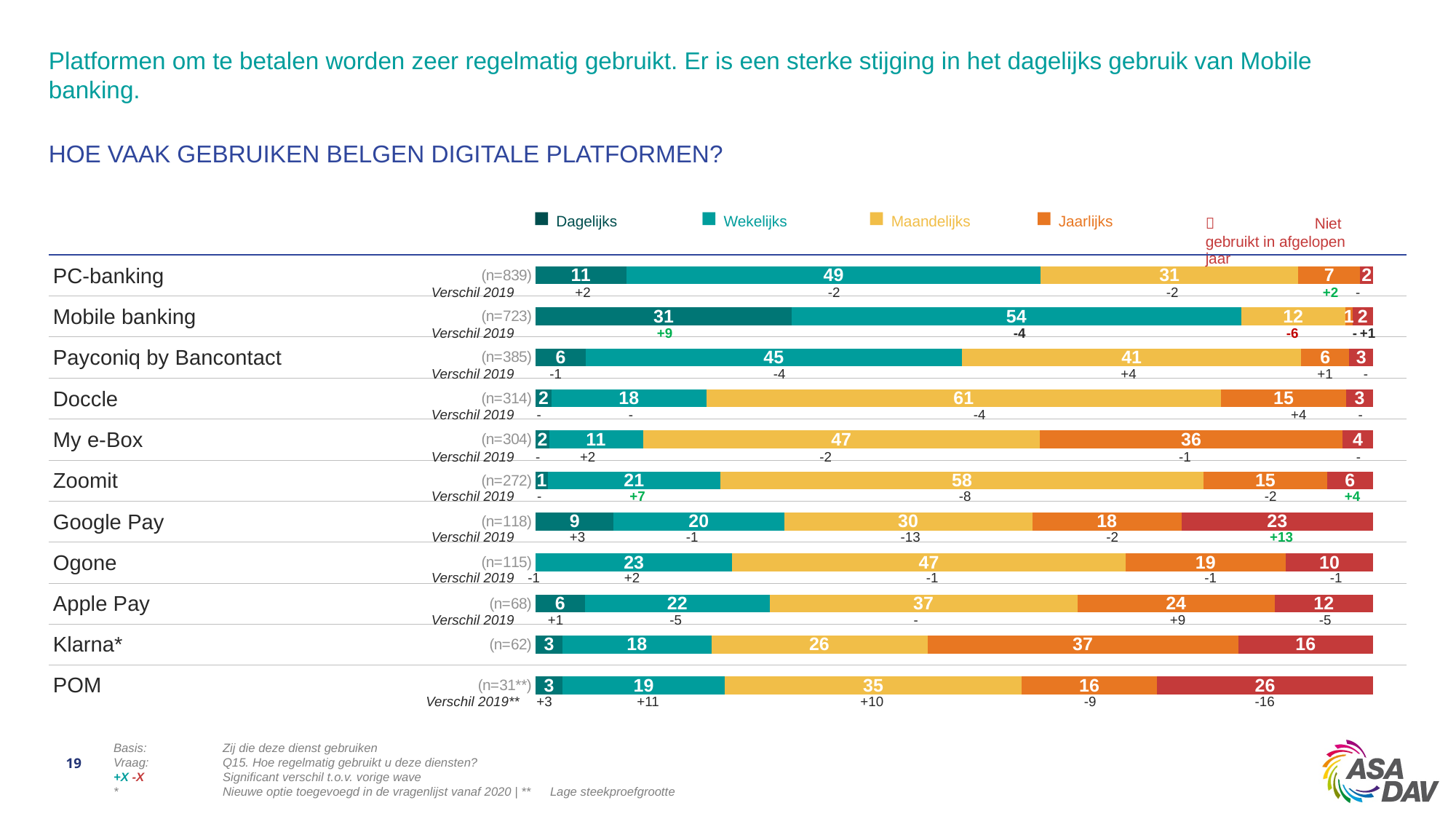
What kind of chart is shown on the slide? Stacked bar chart How many platforms are shown in the chart? 11 What is the Wekelijks value for Mobile banking? 54 What is the Maandelijks value for Doccle? 61 What is the total of the stacked bar for PC-banking? 100 What is the difference between the Wekelijks values for PC-banking and Payconiq by Bancontact? 4 Which platform has the highest value for 'Niet gebruikt in afgelopen jaar'? POM How many series does the legend list? 5 Which platform has the highest Dagelijks value? Mobile banking Which has the larger Maandelijks value, Zoomit or Ogone? Zoomit What is the 'Verschil 2019' value shown for the Dagelijks segment of Mobile banking? +9 What is the Jaarlijks value for My e-Box? 36